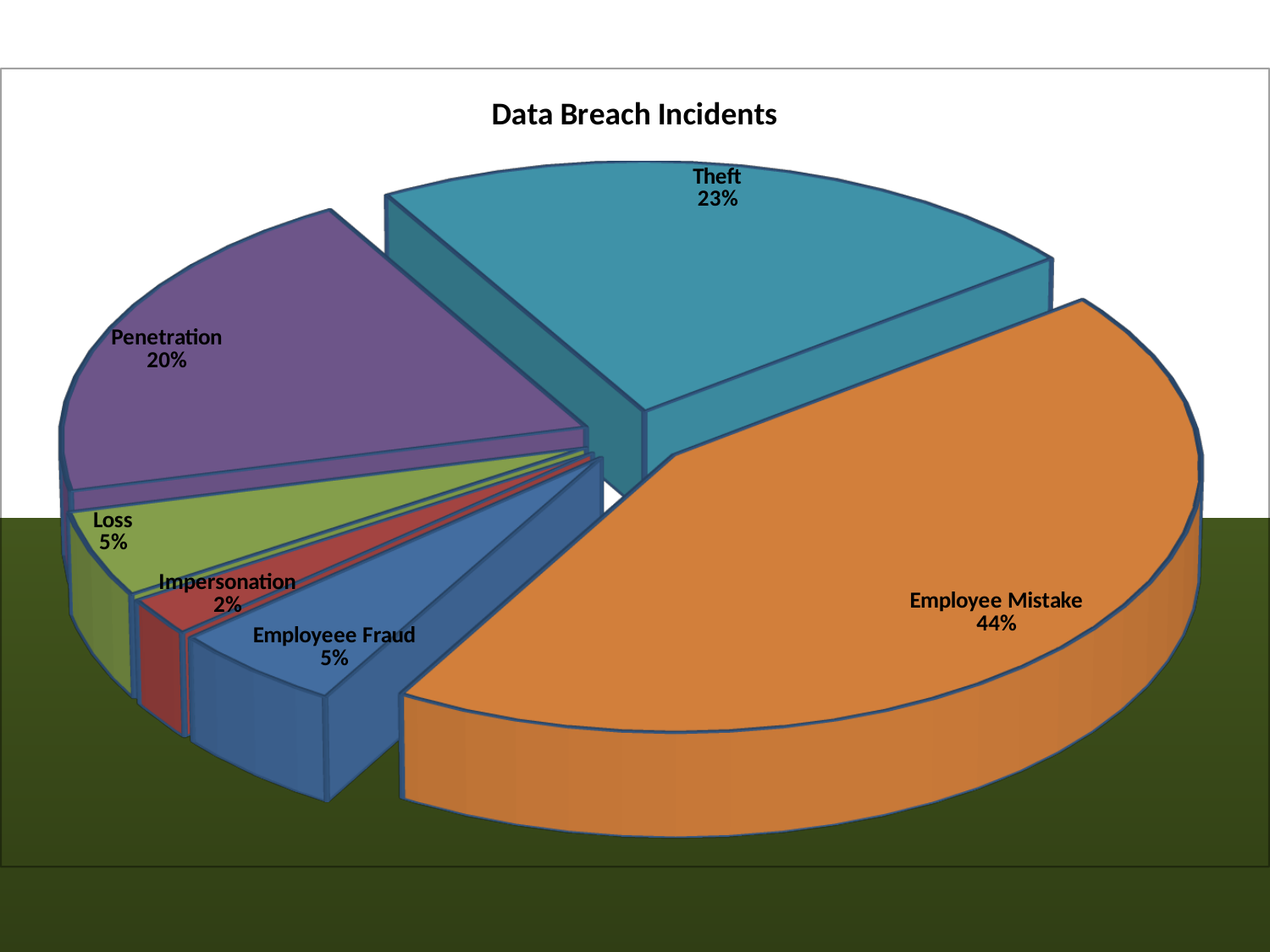
What is the difference in percentage points between Employee Mistake and Theft? 21% Which category has the smallest slice of the pie? Impersonation Which is larger, the share for Theft or the share for Penetration? Theft What share of data breach incidents is attributed to Employee Mistake? 44% What is the title of the chart? Data Breach Incidents What percentage is shown for Impersonation? 2% What percentage is shown for Theft? 23% What colour is the Employee Mistake slice? orange Which category has the largest slice of the pie? Employee Mistake What kind of chart is shown on the slide? pie chart What percentage is shown for Penetration? 20% How many categories are shown in the pie chart? 6